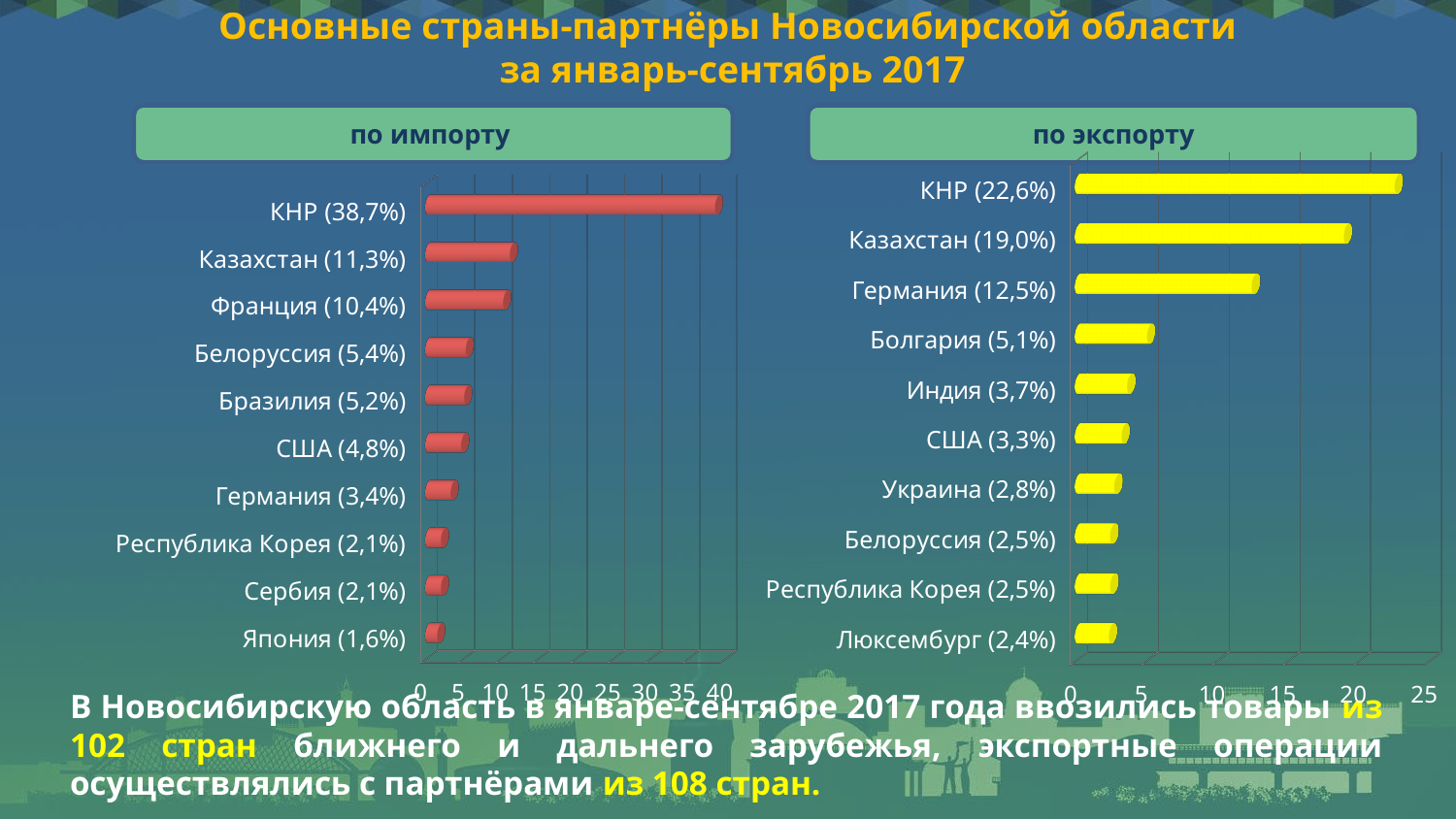
On the 'по экспорту' chart, what is the difference between the values for КНР and Казахстан? 3,6% On the 'по импорту' chart, which country has the highest value? КНР On the 'по экспорту' chart, which country has the lowest value? Люксембург On the 'по импорту' chart, what is the difference between the values for КНР and Казахстан? 27,4% What kind of chart is the 'по экспорту' chart? bar chart On the 'по экспорту' chart, is the value for Казахстан greater or less than 15? greater On the 'по импорту' chart, what is the value for Казахстан? 11,3% What colour are the bars on the 'по экспорту' chart? yellow On the 'по импорту' chart, what is the value for Япония? 1,6% On the 'по экспорту' chart, what is the value for Германия? 12,5% On the 'по экспорту' chart, which is larger, the value for Болгария or the value for Индия? Болгария How many countries are shown on the 'по импорту' chart? 10